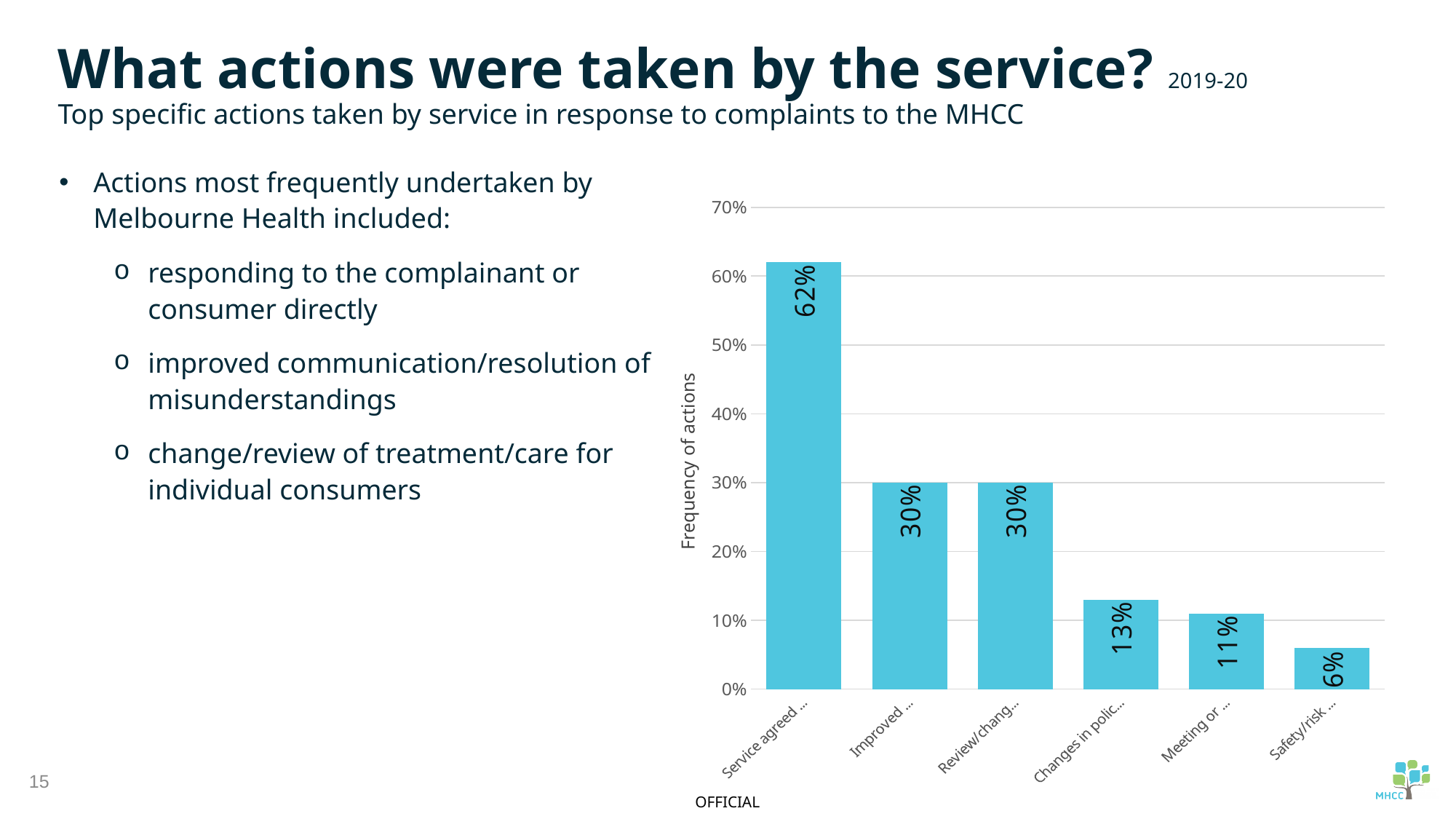
What is the value of the first bar, labelled "Service agreed ..."? 62% What is the value of the bar labelled "Meeting or ..."? 11% Which bar has the lowest value? Safety/risk ... How many bars are shown in the chart? 6 What is the value of the last bar, labelled "Safety/risk ..."? 6% Which bar has the highest value? Service agreed ... What is the label of the vertical axis of the chart? Frequency of actions What is the difference between the "Changes in polic..." bar and the "Safety/risk ..." bar? 7% Which is larger, the value for "Review/chang..." or the value for "Meeting or ..."? Review/chang... What is the difference between the "Service agreed ..." bar and the "Improved ..." bar? 32% What kind of chart is shown on the slide? Bar chart What is the value of the bar labelled "Changes in polic..."? 13%